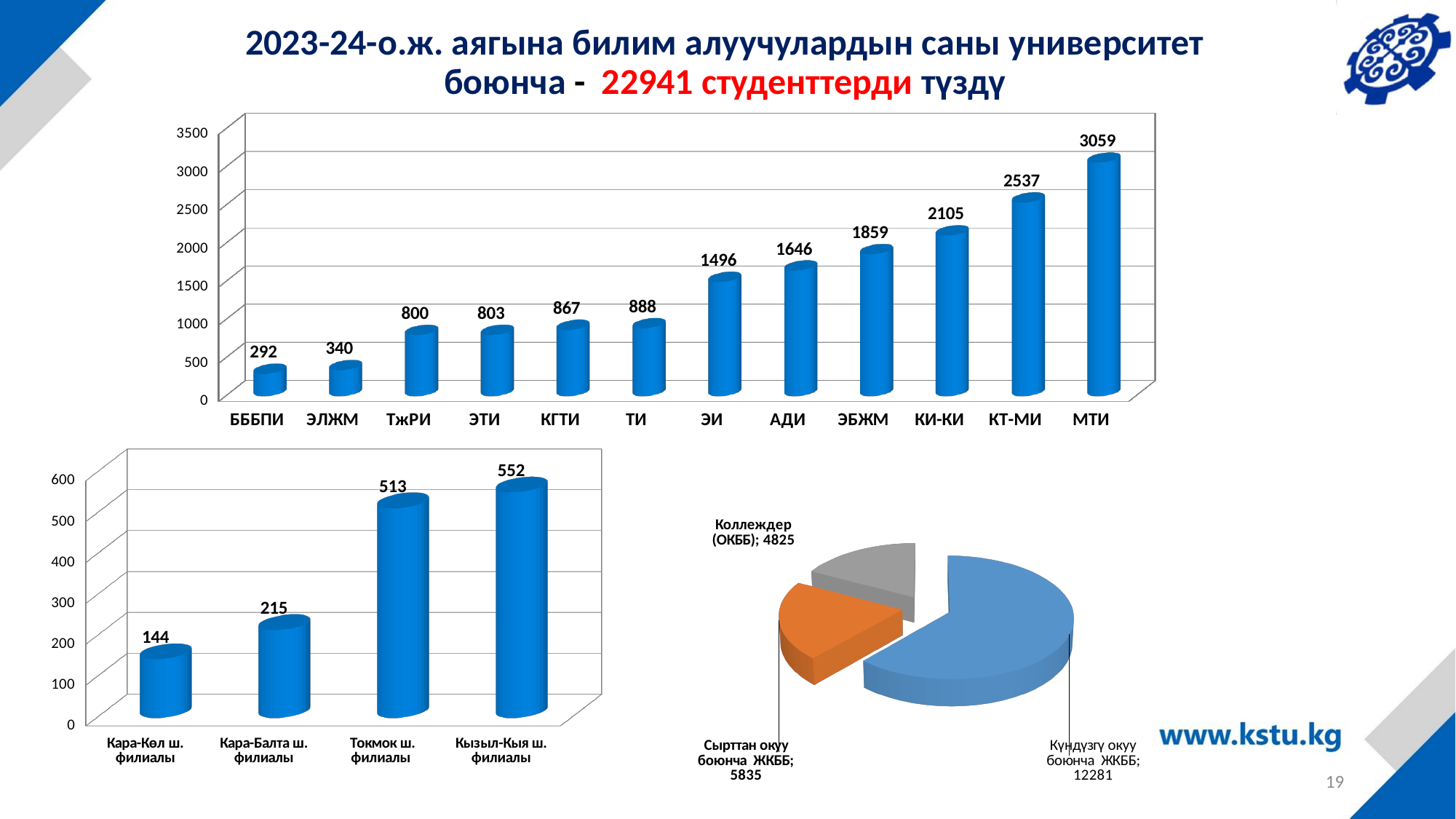
In the pie chart at the bottom right, what is the value for Коллеждер (ОКББ)? 4825 In the top bar chart, what is the value for ЭИ? 1496 In the bottom-left bar chart, which is larger: the value for Кара-Балта ш. филиалы or Кара-Көл ш. филиалы? Кара-Балта ш. филиалы In the bottom-left bar chart, which category has the highest value? Кызыл-Кыя ш. филиалы In the top bar chart, what is the value for МТИ? 3059 In the top bar chart, how many categories are shown on the x axis? 12 In the top bar chart, do the values rise or fall from left to right along the x axis? rise In the top bar chart, what is the difference between the values for МТИ and КТ-МИ? 522 In the top bar chart, which category has the lowest value? БББПИ In the bottom-left bar chart, what is the difference between the values for Кызыл-Кыя ш. филиалы and Токмок ш. филиалы? 39 In the bottom-left bar chart, what is the value for Токмок ш. филиалы? 513 In the pie chart at the bottom right, which slice is the largest? Күндүзгү окуу боюнча ЖКББ